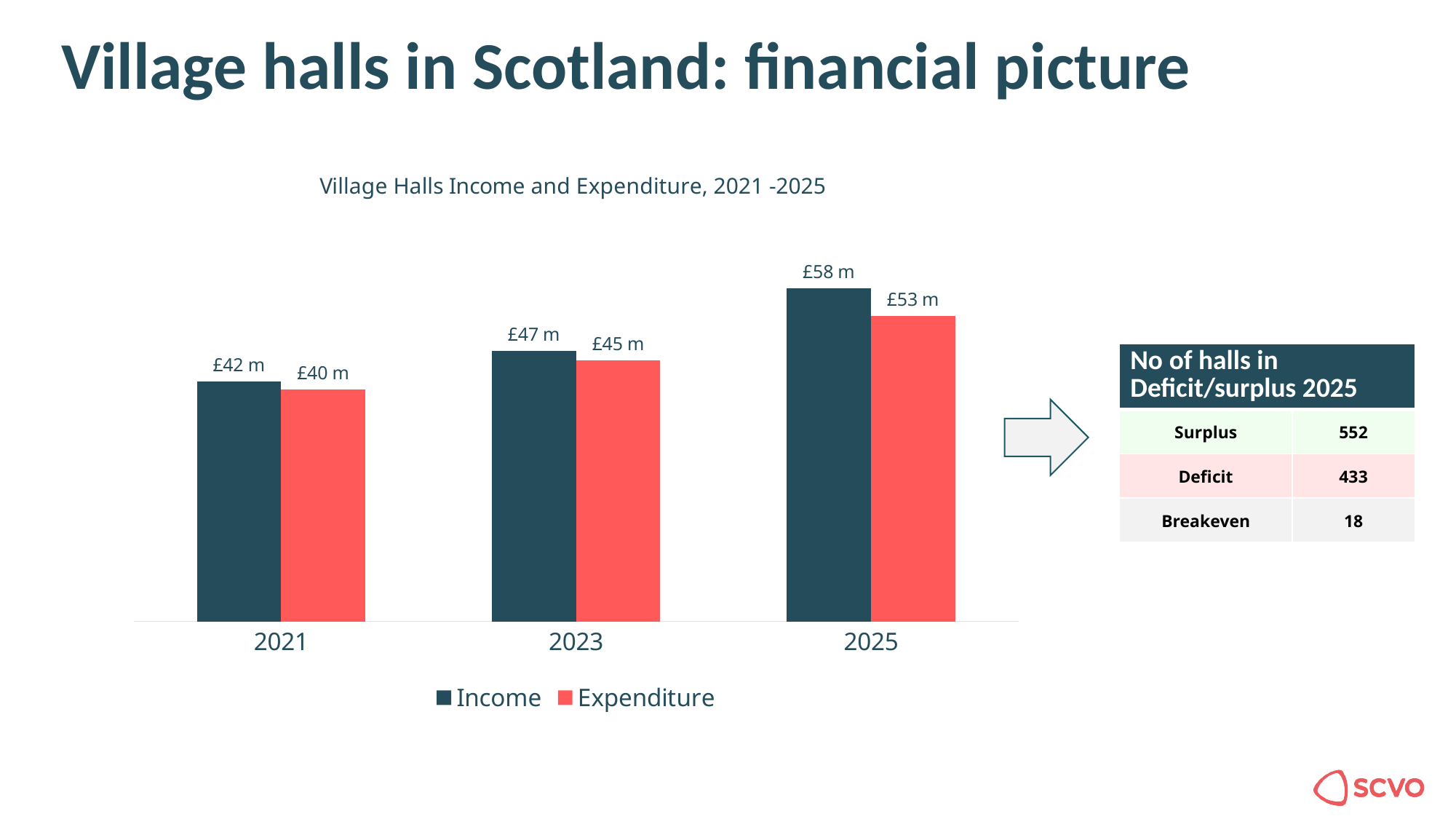
Which is larger in 2023, Income or Expenditure? Income What is the Expenditure value for 2023? £45 m Which year has the lowest Expenditure? 2021 What kind of chart is shown? Bar chart What is the Expenditure value for 2021? £40 m How many years are shown on the x axis? 3 Does Income rise or fall from 2021 to 2025? Rise Which year has the highest Income? 2025 What is the Income value for 2025? £58 m What is the difference between Income and Expenditure in 2025? £5 m How many series does the legend list? 2 What is the difference between Income in 2023 and Income in 2021? £5 m